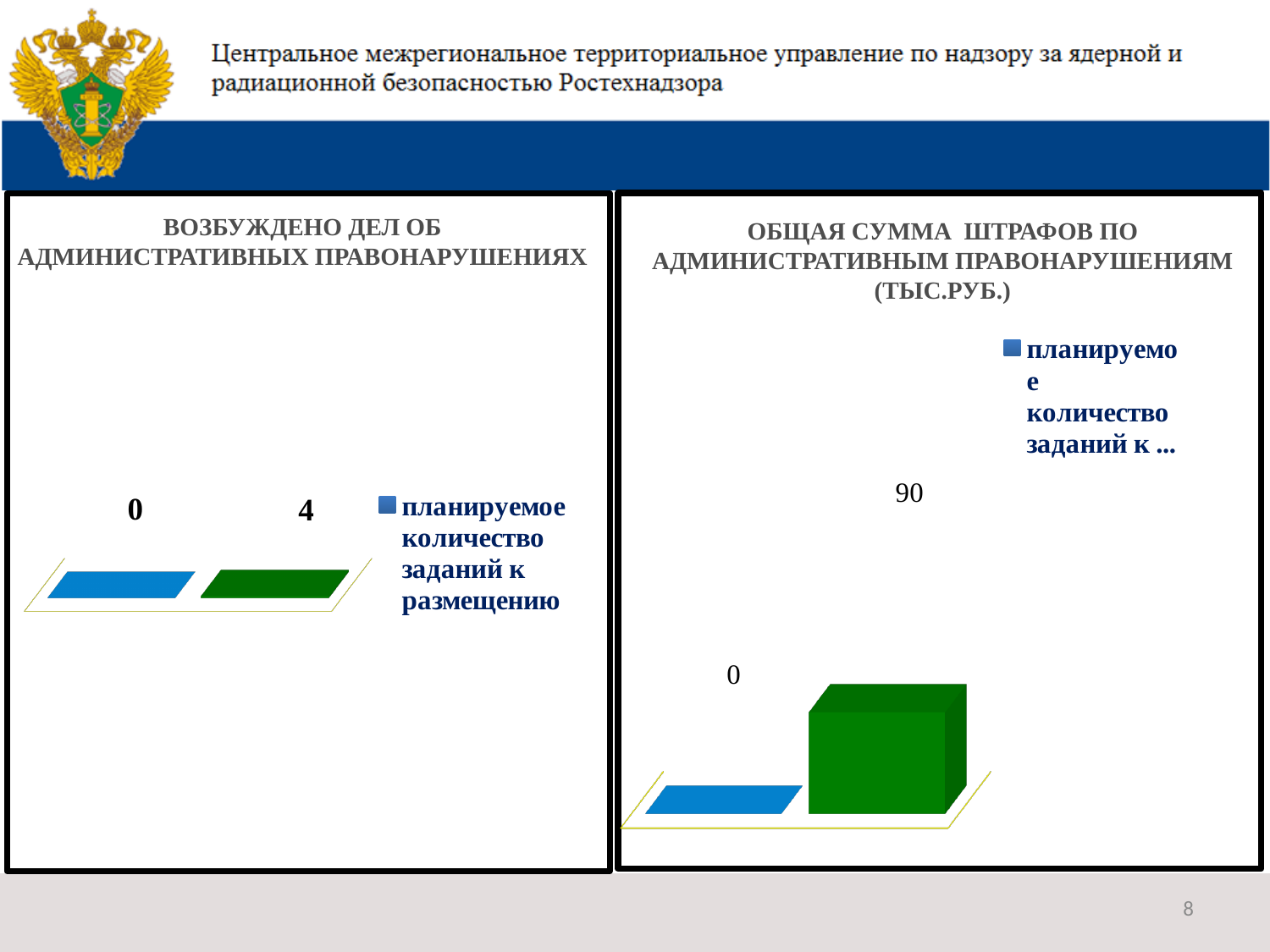
What kind of chart is the right chart 'ОБЩАЯ СУММА ШТРАФОВ ПО АДМИНИСТРАТИВНЫМ ПРАВОНАРУШЕНИЯМ (ТЫС.РУБ.)'? bar chart How many bars are plotted in the left chart? 2 In the left chart, what is the difference between the green bar value and the blue bar value? 4 In the right chart 'ОБЩАЯ СУММА ШТРАФОВ ПО АДМИНИСТРАТИВНЫМ ПРАВОНАРУШЕНИЯМ (ТЫС.РУБ.)', what value is shown on the green bar? 90 What is the legend entry shown in the left chart? планируемое количество заданий к размещению In the left chart, which bar has the highest value, the blue one or the green one? the green one In the left chart 'ВОЗБУЖДЕНО ДЕЛ ОБ АДМИНИСТРАТИВНЫХ ПРАВОНАРУШЕНИЯХ', what value is shown on the green bar? 4 In the right chart, which bar is larger, the blue one or the green one? the green one In the left chart 'ВОЗБУЖДЕНО ДЕЛ ОБ АДМИНИСТРАТИВНЫХ ПРАВОНАРУШЕНИЯХ', what value is shown on the blue bar? 0 In the right chart, what is the difference between the green bar value and the blue bar value? 90 In the right chart 'ОБЩАЯ СУММА ШТРАФОВ ПО АДМИНИСТРАТИВНЫМ ПРАВОНАРУШЕНИЯМ (ТЫС.РУБ.)', what value is shown on the blue bar? 0 How many bars are plotted in the right chart? 2